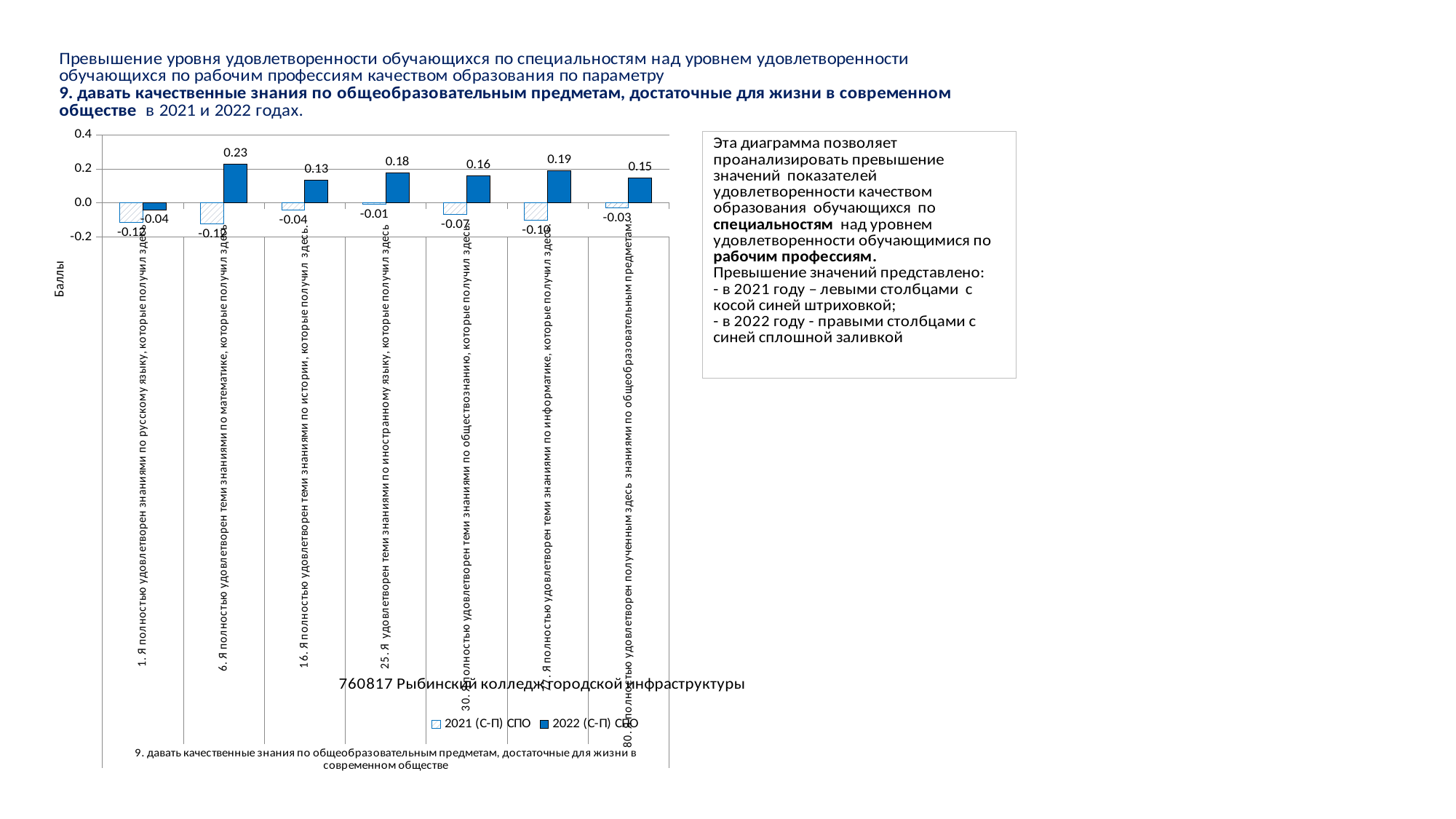
What is the difference between the 2022 and 2021 values for the statement about foreign language (иностранному языку)? 0.19 How many categories (survey statements) are plotted on the chart? 7 What is the 2022 (С-П) СПО value for the statement about knowledge of mathematics (математике)? 0.23 What is the 2021 (С-П) СПО value for the statement about knowledge of informatics (информатике)? -0.10 Which statement has the highest 2022 (С-П) СПО value? 6. Я полностью удовлетворен теми знаниями по математике, которые получил здесь How many series does the chart legend list? 2 For 2022 (С-П) СПО, which is larger: the value for informatics (информатике) or for social studies (обществознанию)? информатике Which statement has the lowest 2022 (С-П) СПО value? 1. Я полностью удовлетворен знаниями по русскому языку, которые получил здесь What is the 2022 (С-П) СПО value for the statement about knowledge of history (истории)? 0.13 What is the title of the vertical axis? Баллы What kind of chart is shown on the slide? bar chart What is the 2022 (С-П) СПО value for the statement about knowledge of social studies (обществознанию)? 0.16